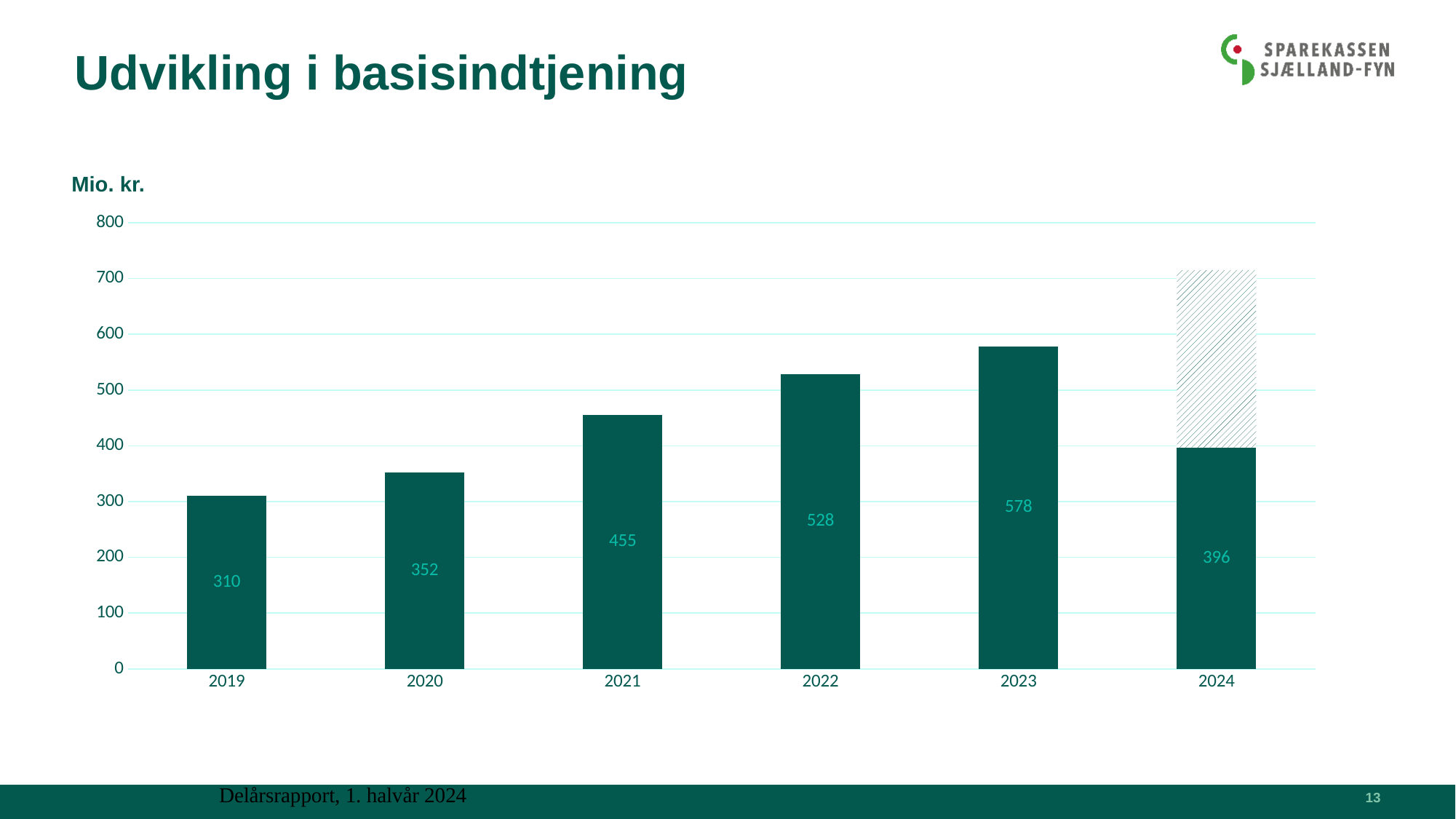
Do the values rise or fall from 2019 to 2023? Rise Which is larger, the value for 2021 or the value for 2024? 2021 What is the difference between the values for 2023 and 2022? 50 What is the value for 2019? 310 Is the top of the hatched extension above the 2024 bar greater or less than 700? greater What is the difference between the values for 2020 and 2019? 42 How many years are shown on the x axis? 6 Which year has the lowest value? 2019 What is the value for 2021? 455 What kind of chart is shown on the slide? Bar chart Which year has the highest labelled value? 2023 What is the value for 2024 (solid bar)? 396